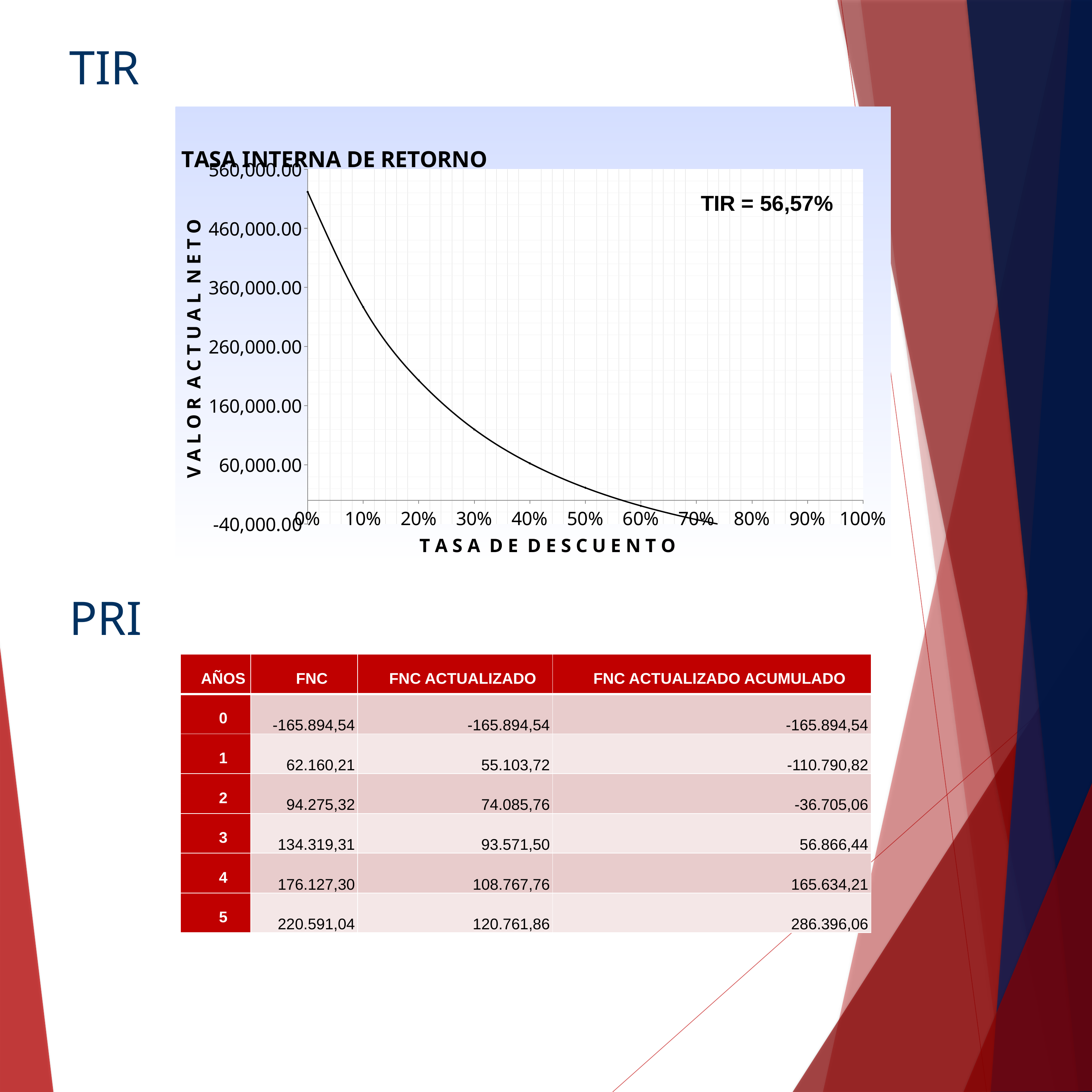
Which has a larger VALOR ACTUAL NETO on the chart: a TASA DE DESCUENTO of 10% or of 40%? 10% What is the title of the chart? TASA INTERNA DE RETORNO What TIR value is annotated on the chart? TIR = 56,57% At which TASA DE DESCUENTO is the VALOR ACTUAL NETO highest on the chart? 0% Does the VALOR ACTUAL NETO rise or fall as the TASA DE DESCUENTO increases along the x axis? fall Is the VALOR ACTUAL NETO at a TASA DE DESCUENTO of 30% greater or less than 160,000.00? less Is the VALOR ACTUAL NETO at a TASA DE DESCUENTO of 0% greater or less than 460,000.00? greater What kind of chart is shown under the heading TIR? line chart Is the VALOR ACTUAL NETO at a TASA DE DESCUENTO of 10% greater or less than 260,000.00? greater What is the label of the x axis of the chart? TASA DE DESCUENTO